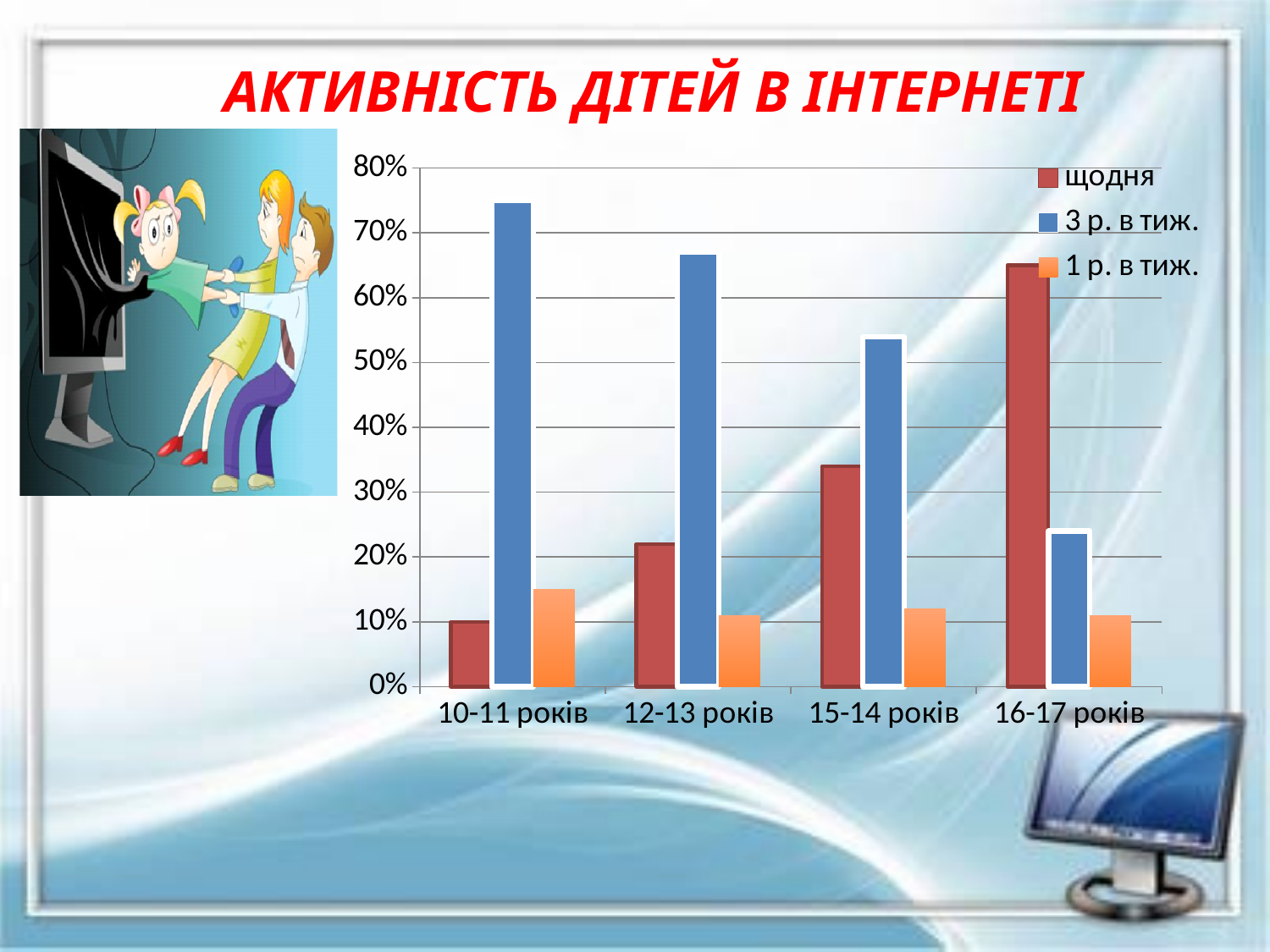
Is the value for "1 р. в тиж." in the 16-17 років group greater or less than 20%? less What kind of chart is shown on the slide? bar chart Do the values for the series "3 р. в тиж." rise or fall from the 10-11 років group to the 16-17 років group? fall Do the values for the series "щодня" rise or fall from the 10-11 років group to the 16-17 років group? rise What is the title shown above the chart on the slide? АКТИВНІСТЬ ДІТЕЙ В ІНТЕРНЕТІ Which age group has the highest value for the series "щодня"? 16-17 років Is the value for "щодня" in the 15-14 років group greater or less than 30%? greater In the 12-13 років group, which series has the larger value: "щодня" or "3 р. в тиж."? 3 р. в тиж. How many series does the chart legend list? 3 How many age groups are shown on the x axis of the chart? 4 Which age group has the lowest value for the series "3 р. в тиж."? 16-17 років Is the value for "3 р. в тиж." in the 10-11 років group greater or less than 70%? greater